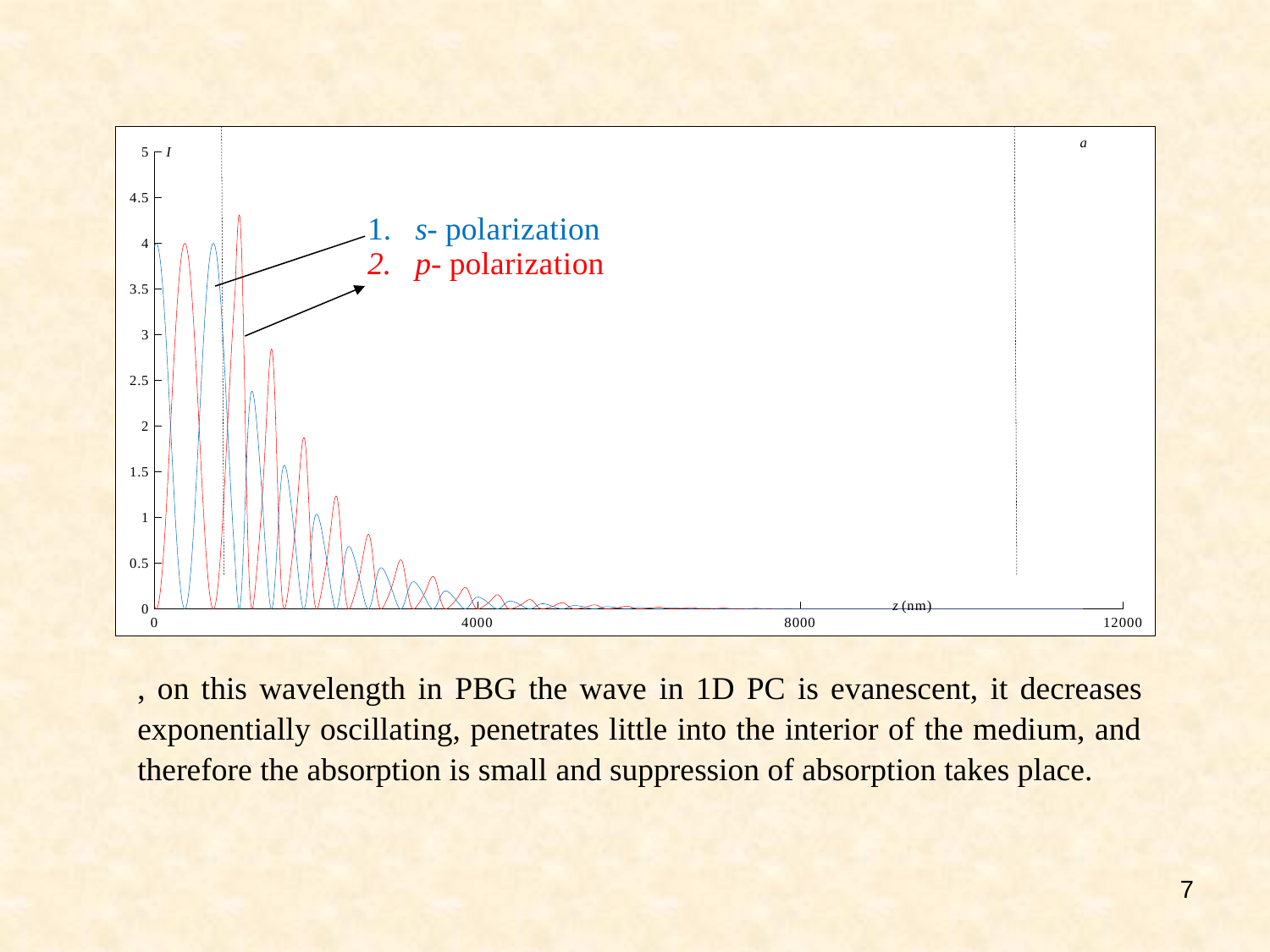
What is the maximum value shown on the y axis? 5 Is the value of the p- polarization curve at z = 4000 nm greater or less than 1? less Which series is drawn in red? p- polarization Is the value of the s- polarization curve at z = 8000 nm greater or less than 0.5? less What kind of chart is shown on the slide? line chart How many series does the legend list? 2 What is the label of the x axis? z (nm) Which series is drawn in blue? s- polarization Is the highest peak of the p- polarization curve greater or less than 4? greater What is the maximum value shown on the x axis? 12000 Overall, do the oscillation amplitudes of the curves rise or fall as z increases? fall What is the label of the y axis? I